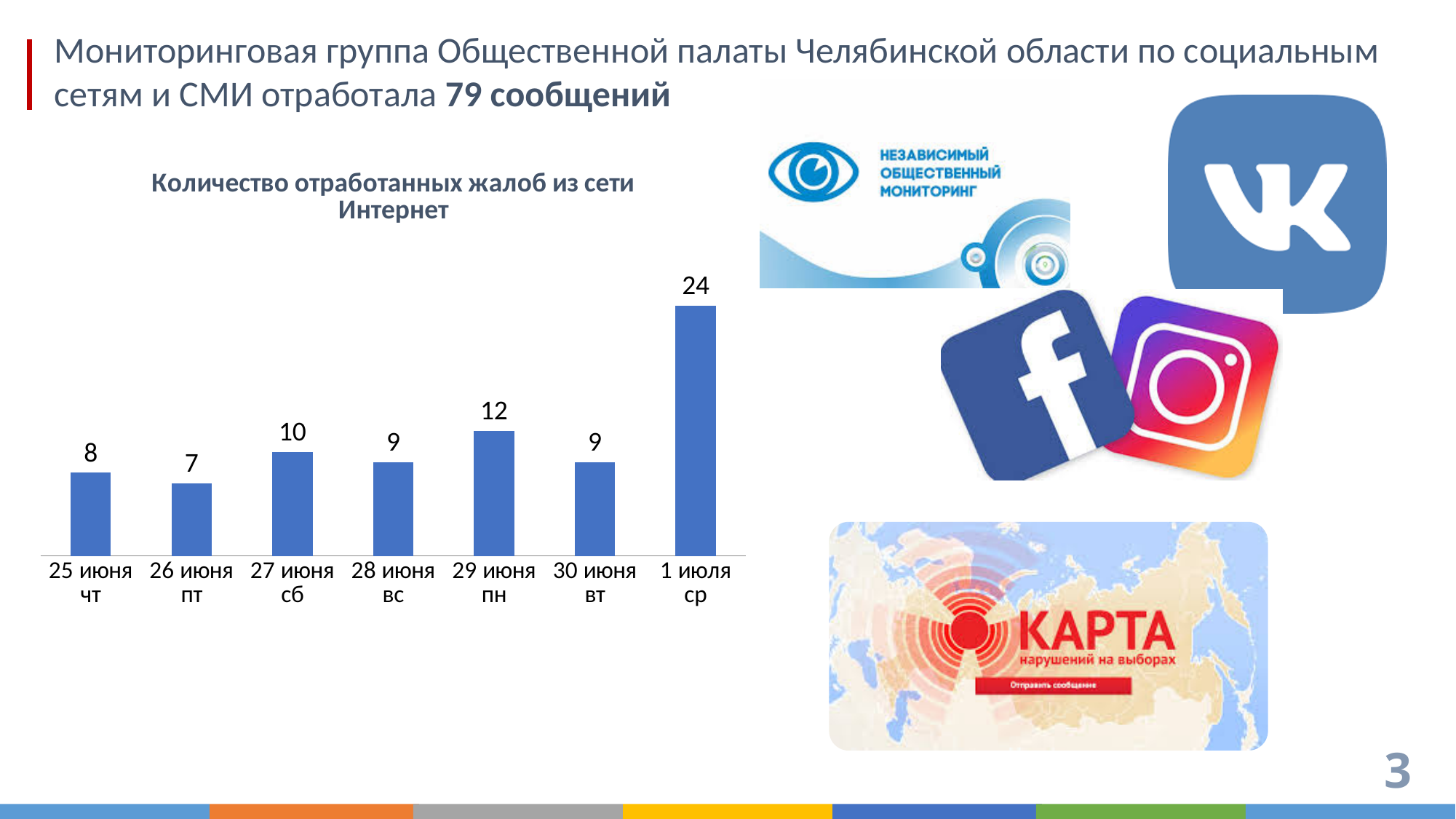
Which is larger, the value for 27 июня сб or the value for 30 июня вт? 27 июня сб What is the difference between the values for 27 июня сб and 25 июня чт? 2 What is the value for 26 июня пт? 7 How many days are shown on the chart? 7 What is the difference between the values for 1 июля ср and 29 июня пн? 12 What kind of chart is shown? bar chart Which day has the lowest value? 26 июня пт What is the value for 29 июня пн? 12 Which day has the highest value? 1 июля ср What is the title of the chart? Количество отработанных жалоб из сети Интернет What is the value for 1 июля ср? 24 What is the total of all values shown on the chart? 79